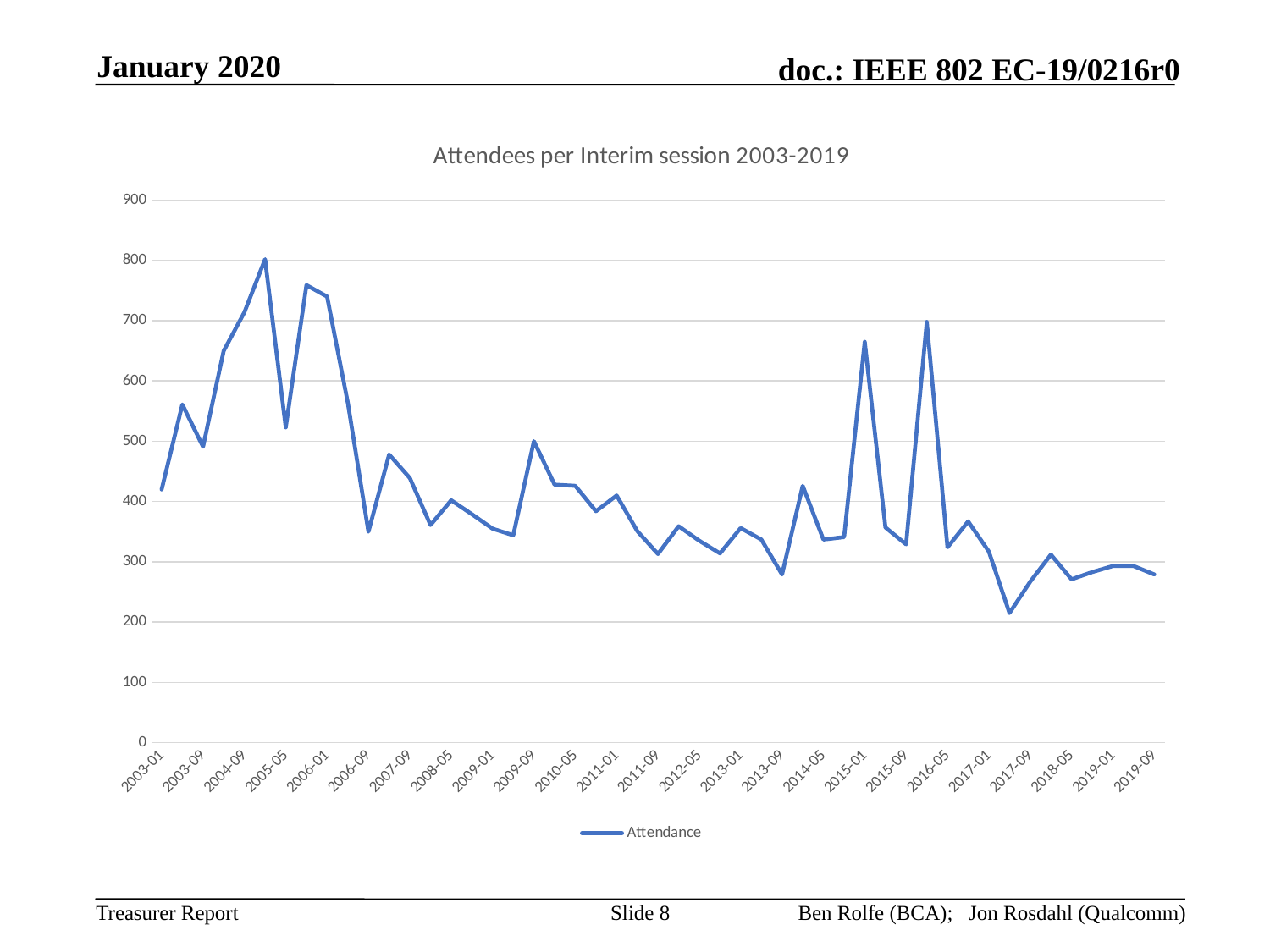
Is the value for 2016-05 greater or less than 400? less Is the value for 2006-09 greater or less than 400? less What is the title of the chart? Attendees per Interim session 2003-2019 Is the value for 2006-01 greater or less than 700? greater What is the name of the series shown in the legend? Attendance Which has the higher attendance, 2003-09 or 2006-09? 2003-09 Overall, does attendance rise or fall from 2003-01 to 2019-09? fall What kind of chart is shown on the slide? line chart How many series does the legend list? 1